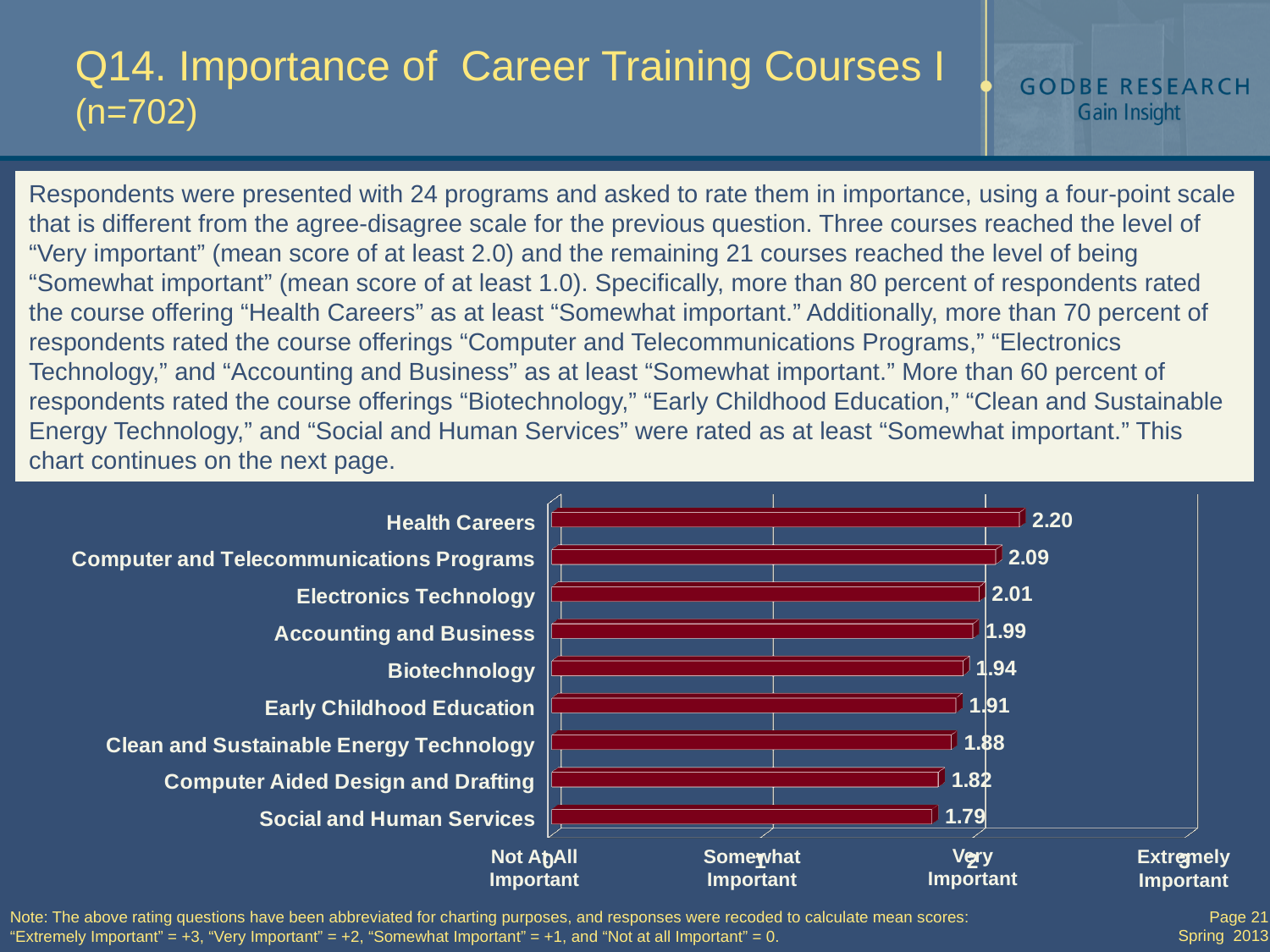
What is the mean importance score for Social and Human Services? 1.79 What type of chart is shown on the slide? Bar chart What is the mean importance score for Health Careers? 2.20 Which course has the highest mean importance score? Health Careers What is the mean importance score for Biotechnology? 1.94 What is the mean importance score for Computer Aided Design and Drafting? 1.82 Which has a higher mean score, Early Childhood Education or Clean and Sustainable Energy Technology? Early Childhood Education What label appears at the value 3 on the horizontal axis? Extremely Important What is the difference between the mean scores for Health Careers and Social and Human Services? 0.41 How many courses are shown in the chart? 9 What is the difference between the mean scores for Computer and Telecommunications Programs and Electronics Technology? 0.08 Which course has the lowest mean importance score? Social and Human Services